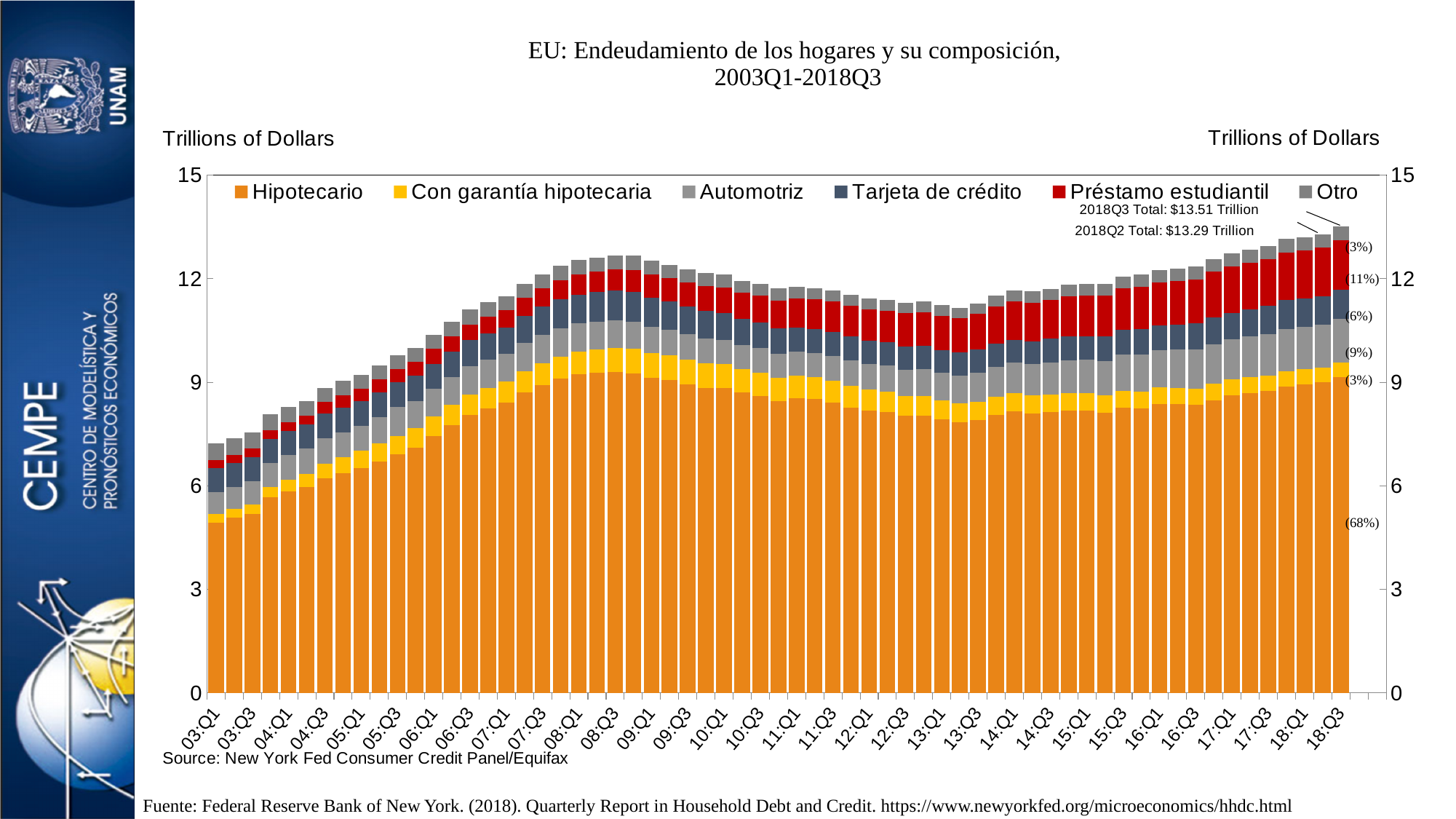
Which quarter has the lowest total household debt? 03:Q1 What unit is shown on the vertical axis? Trillions of Dollars What share of the 2018Q3 total is Préstamo estudiantil (student loans)? 11% What is the total household debt for 2018Q2 according to the annotation? $13.29 Trillion Is the total stacked value for 03:Q1 greater or less than 9? less What kind of chart is shown on the slide? Stacked bar chart What share of the 2018Q3 total is Hipotecario (mortgage) debt? 68% By how much did the total change from 2018Q2 to 2018Q3? $0.22 Trillion What is the total household debt for 2018Q3 according to the annotation? $13.51 Trillion Is the total stacked value for 08:Q3 greater or less than 12? greater How many series does the legend list? 6 Which total is larger, 2018Q2 or 2018Q3? 2018Q3